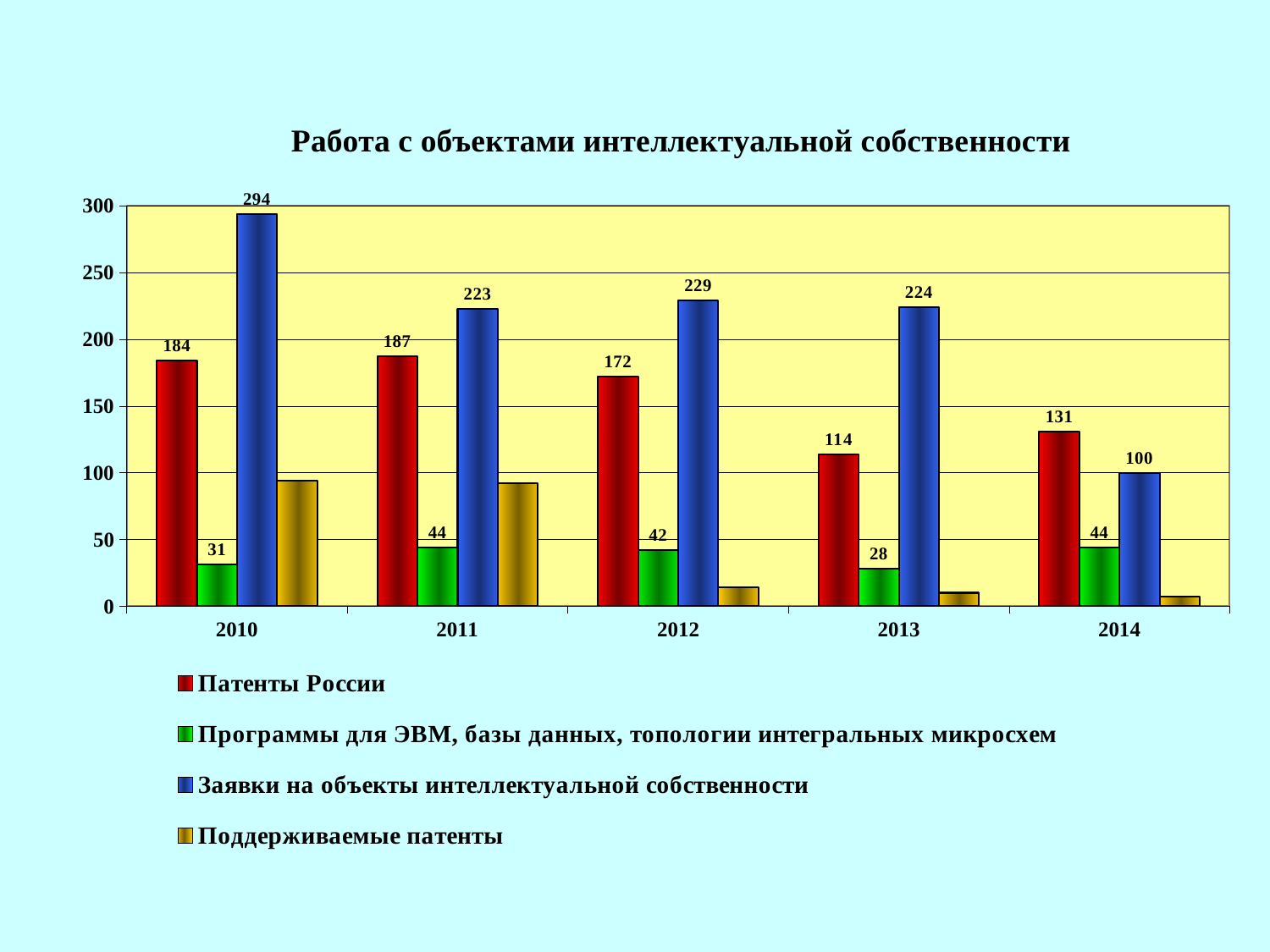
What is the title of the chart? Работа с объектами интеллектуальной собственности In which year is the value for Патенты России the lowest? 2013 Is the value for Поддерживаемые патенты in 2010 greater or less than 50? greater How many series does the legend list? 4 How many years are shown on the x axis? 5 What kind of chart is shown on the slide? Bar chart What is the value for Программы для ЭВМ, базы данных, топологии интегральных микросхем in 2013? 28 What is the value for Патенты России in 2011? 187 What is the difference between the Заявки на объекты интеллектуальной собственности values in 2010 and 2014? 194 What is the value for Заявки на объекты интеллектуальной собственности in 2010? 294 In which year is the value for Заявки на объекты интеллектуальной собственности the highest? 2010 Which is larger: Патенты России in 2014 or Заявки на объекты интеллектуальной собственности in 2014? Патенты России in 2014